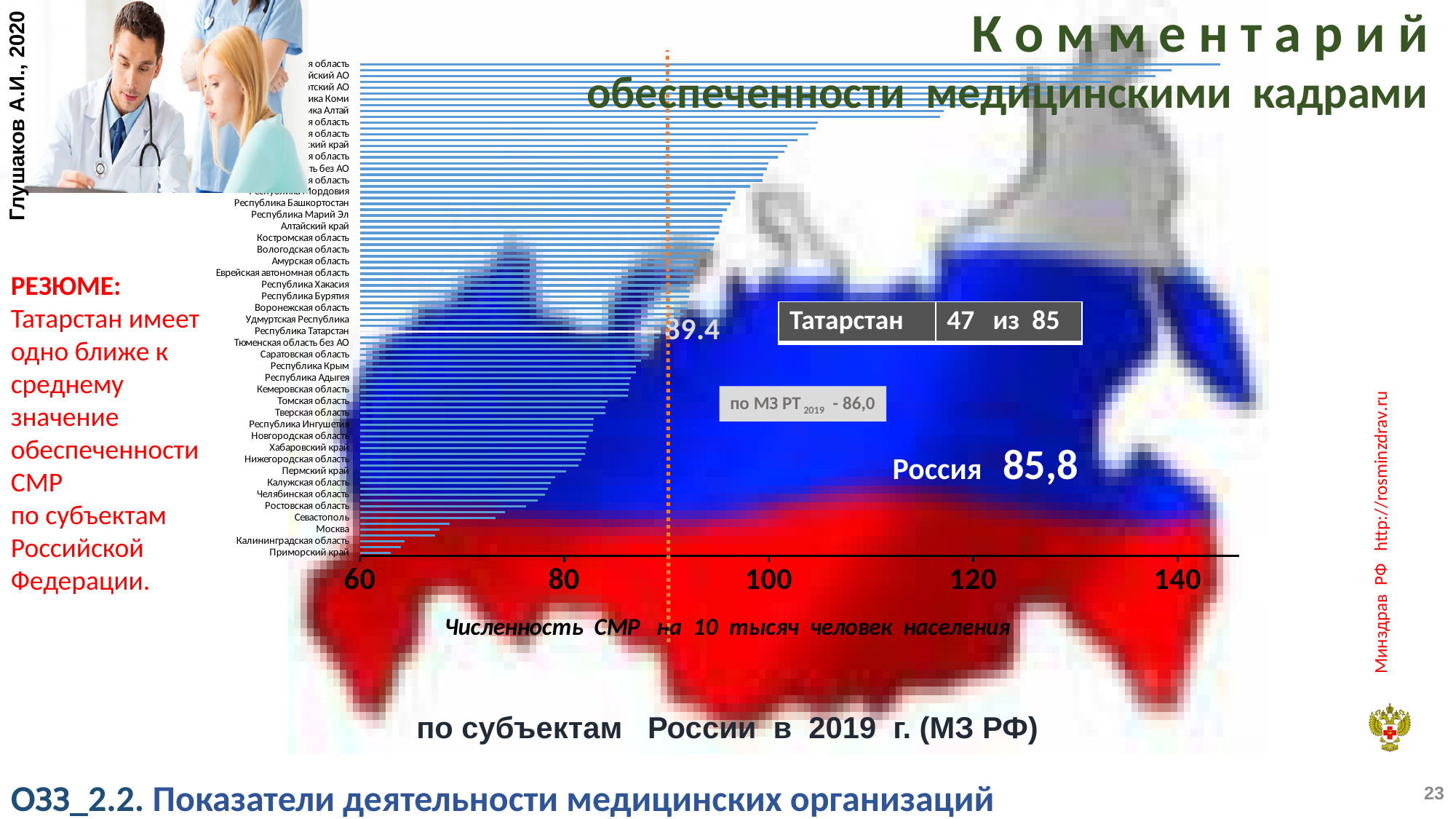
What is the title of the x axis of the chart? Численность СМР на 10 тысяч человек населения What kind of chart is shown on the slide? bar chart Is the value for Республика Башкортостан greater or less than 80? greater Which has the larger value, Приморский край or Республика Марий Эл? Республика Марий Эл Is the value for Москва greater or less than 80? less Do the bars get longer or shorter going from the top of the chart to the bottom? shorter What value is labelled on the bar for Республика Татарстан? 89.4 Is the value for Ростовская область greater or less than 80? less Which has the larger value, Москва or Республика Татарстан? Республика Татарстан What value is shown for Россия on the chart? 85,8